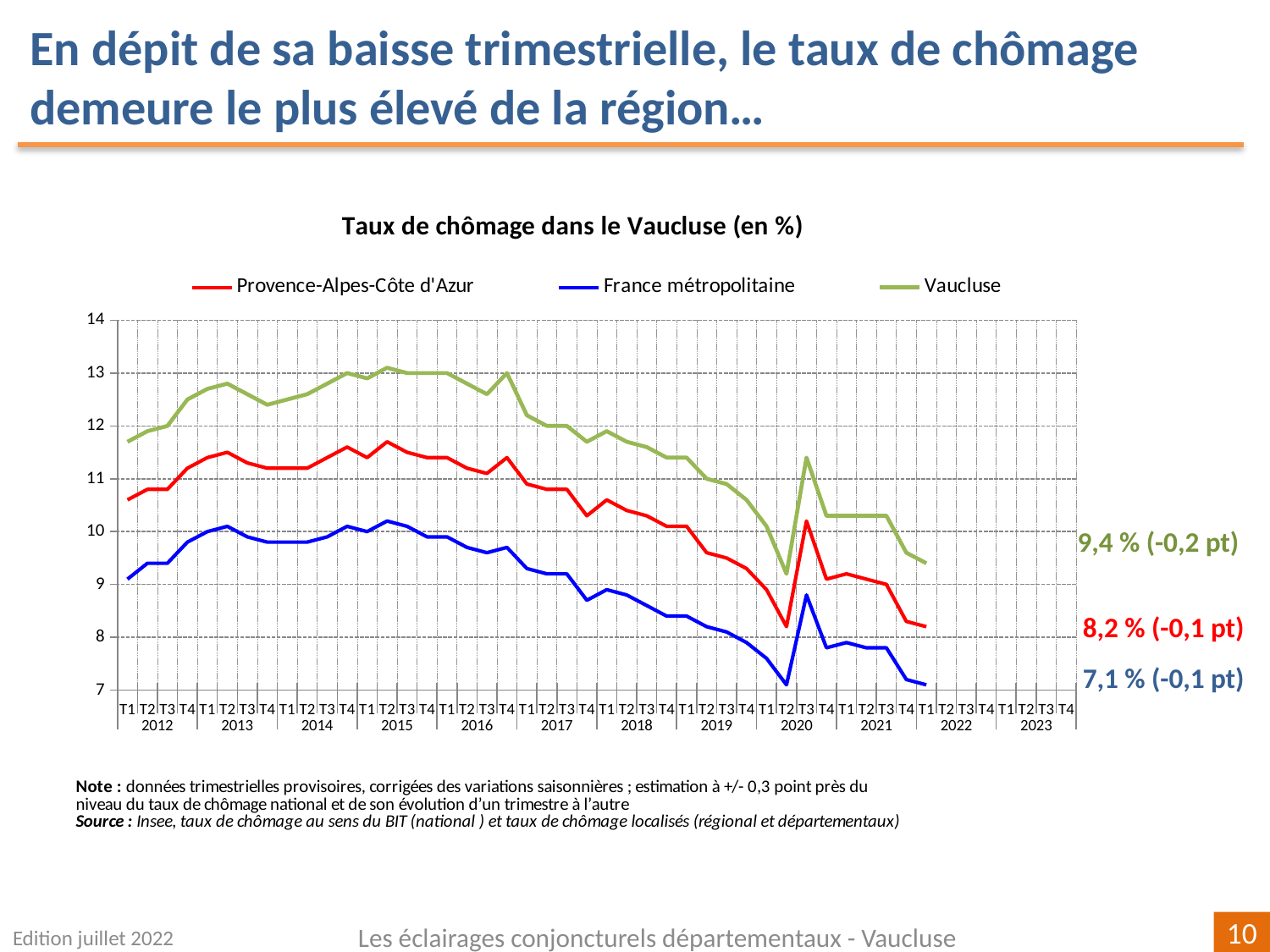
What kind of chart is shown on the slide? line chart How many series does the legend list? 3 Which series has the lowest value at the end of the period? France métropolitaine Is the Vaucluse value in T1 2012 greater or less than 11? greater By how many points did the Vaucluse rate change in the latest quarter, according to the label? -0,2 pt Which series has the highest value at the end of the period? Vaucluse What is the difference between the latest Vaucluse rate and the latest France métropolitaine rate? 2,3 points What is the latest unemployment rate shown for France métropolitaine? 7,1 % What is the latest unemployment rate shown for Provence-Alpes-Côte d'Azur? 8,2 % Overall, does the Vaucluse unemployment rate rise or fall between 2015 and 2022? fall What is the latest unemployment rate shown for Vaucluse? 9,4 % What colour is the line for France métropolitaine? blue